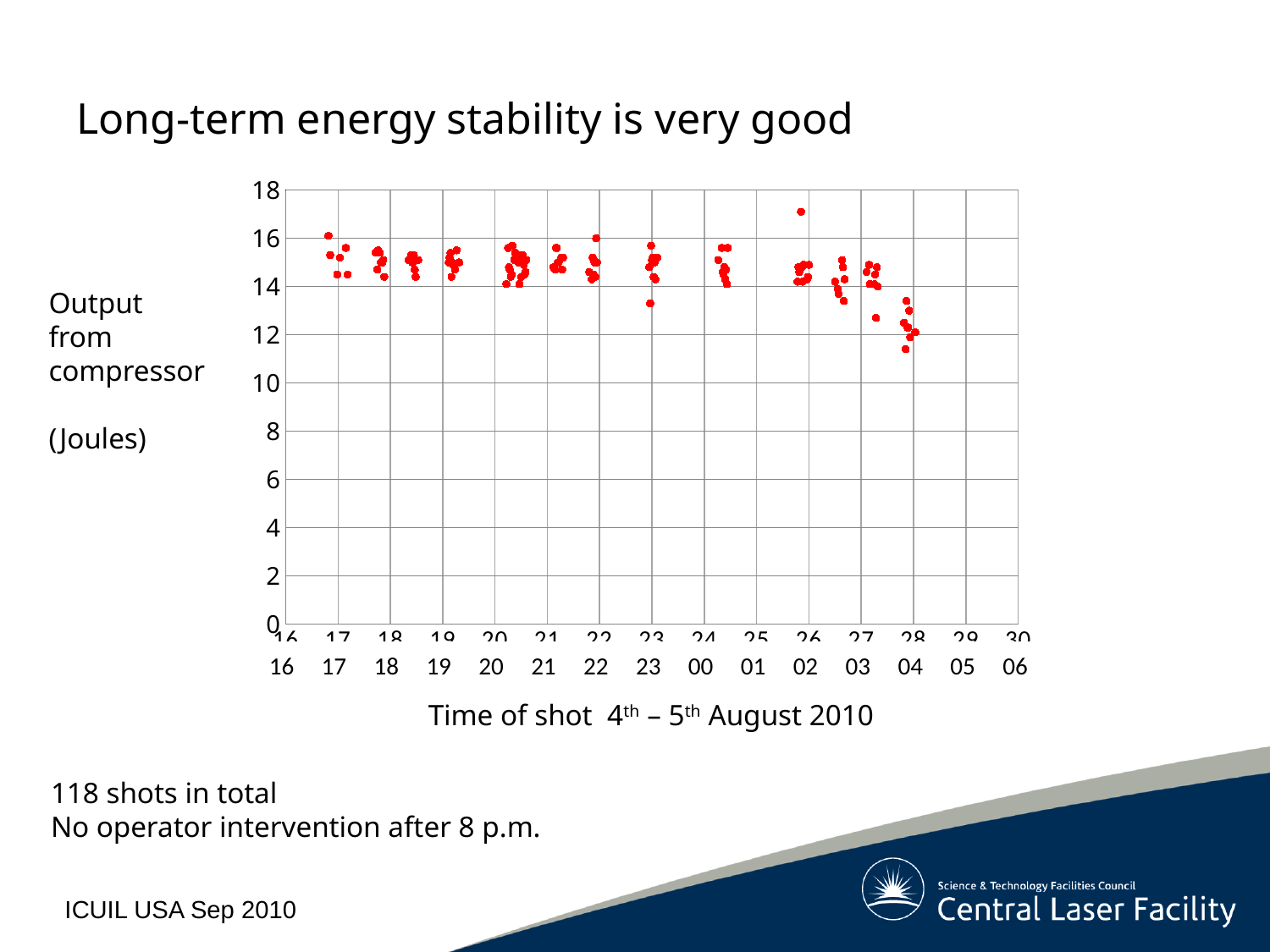
What kind of chart is shown on the slide? scatter plot Are the values plotted at 23 on the time axis greater or less than 10 Joules? greater Are the values plotted at 20 on the time axis greater or less than 12 Joules? greater Do the plotted output values rise or fall toward the right end of the time axis (around 03 to 04)? fall What is the maximum value shown on the y axis of the chart? 18 What is the title of the slide's chart? Long-term energy stability is very good What quantity is plotted on the y axis of the chart? Output from compressor (Joules) Are the values plotted at 17 on the time axis greater or less than 14 Joules? greater How many shots in total are plotted, according to the slide? 118